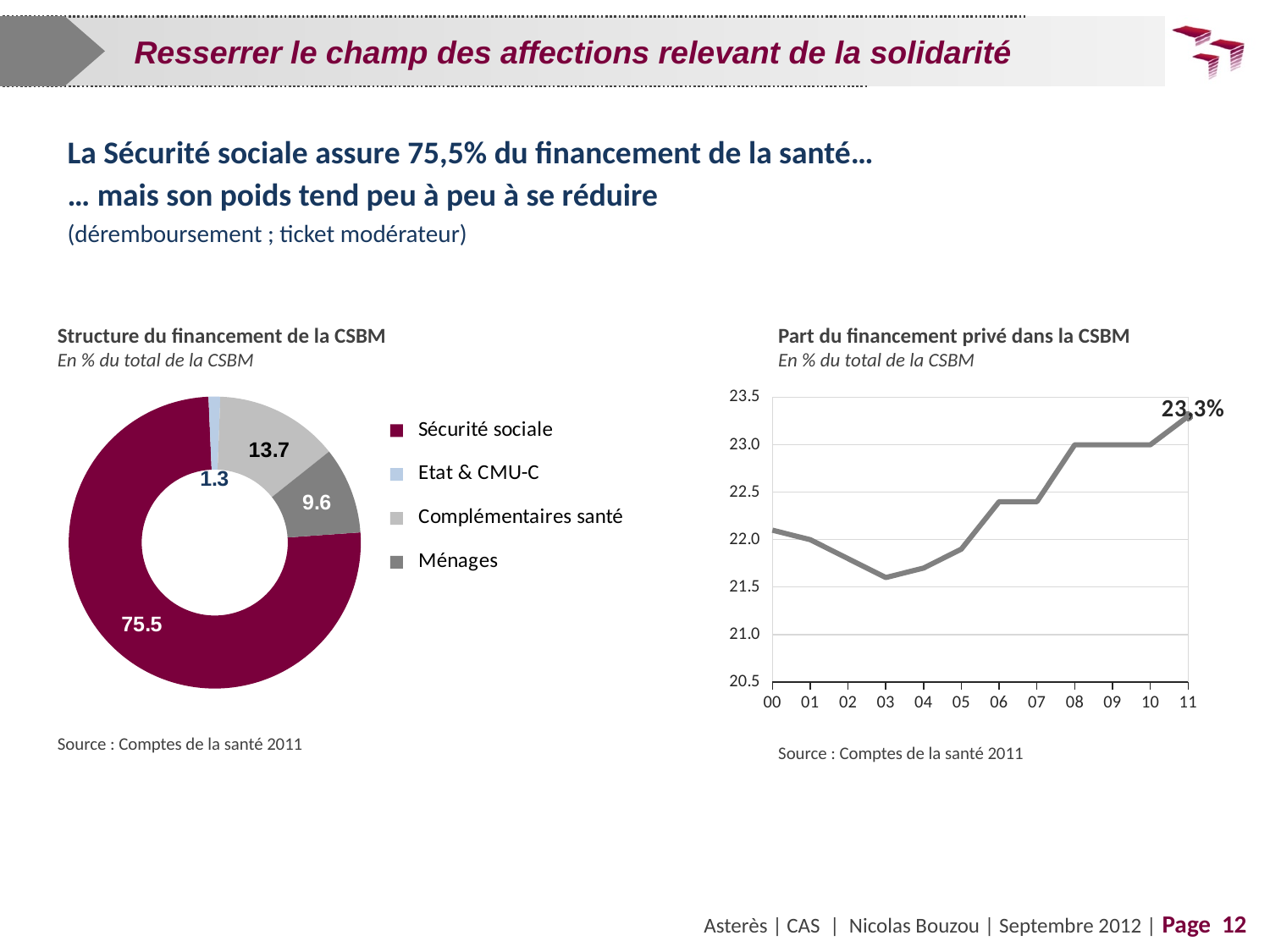
In the chart 'Structure du financement de la CSBM', what is the difference between the values for Complémentaires santé and Ménages? 4.1 In the chart 'Structure du financement de la CSBM', how many categories does the legend list? 4 In the chart 'Part du financement privé dans la CSBM', is the value for 08 greater or less than 22.5? greater In the chart 'Structure du financement de la CSBM', what is the value for Ménages? 9.6 In the chart 'Part du financement privé dans la CSBM', does the value rise or fall between 03 and 11? rise In the chart 'Structure du financement de la CSBM', which category has the largest share? Sécurité sociale What kind of chart is 'Structure du financement de la CSBM'? Doughnut (pie) chart In the chart 'Structure du financement de la CSBM', what is the value for Complémentaires santé? 13.7 In the chart 'Part du financement privé dans la CSBM', what is the value for 11? 23,3% In the chart 'Part du financement privé dans la CSBM', is the value for 03 greater or less than 22.0? less In the chart 'Structure du financement de la CSBM', what is the value for Sécurité sociale? 75.5 In the chart 'Structure du financement de la CSBM', which category has the smallest share? Etat & CMU-C